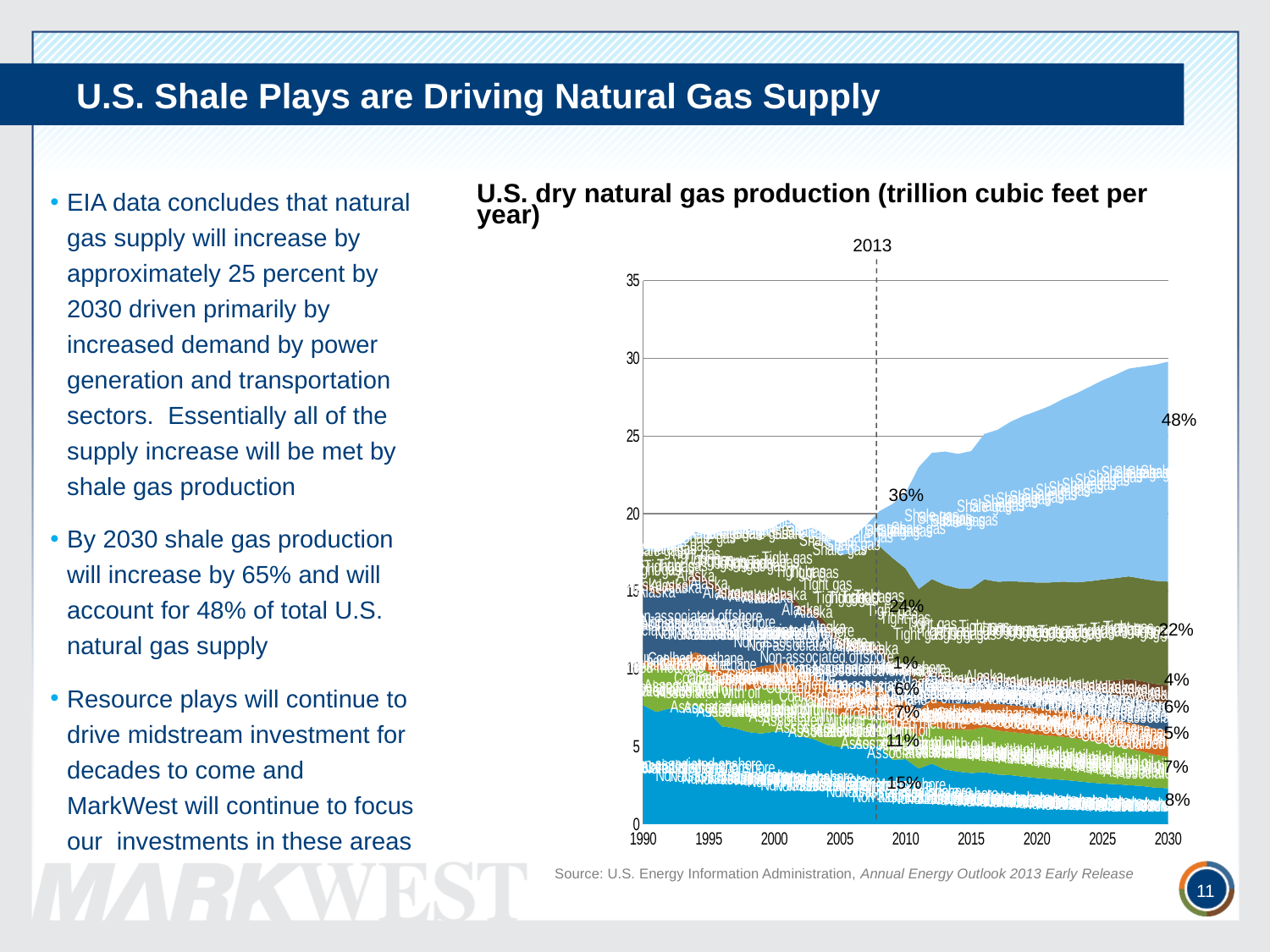
In 2030, which has the larger share of production: shale gas or tight gas? Shale gas What kind of chart is shown on the slide? Stacked area chart Is total U.S. dry natural gas production in 1990 greater or less than 20 trillion cubic feet per year? less What share of U.S. dry natural gas production does tight gas account for in 2030? 22% Does total U.S. dry natural gas production rise or fall between 2013 and 2030? Rise What share of U.S. dry natural gas production does shale gas account for in 2013? 36% What share of U.S. dry natural gas production does tight gas account for in 2013? 24% Which source has the largest share of U.S. dry natural gas production in 2030? Shale gas (48%) By how many percentage points does the shale gas share grow between 2013 and 2030? 12 percentage points Which year is marked by the vertical dashed line on the chart? 2013 Is total U.S. dry natural gas production in 2030 greater or less than 25 trillion cubic feet per year? greater What share of U.S. dry natural gas production does shale gas account for in 2030? 48%